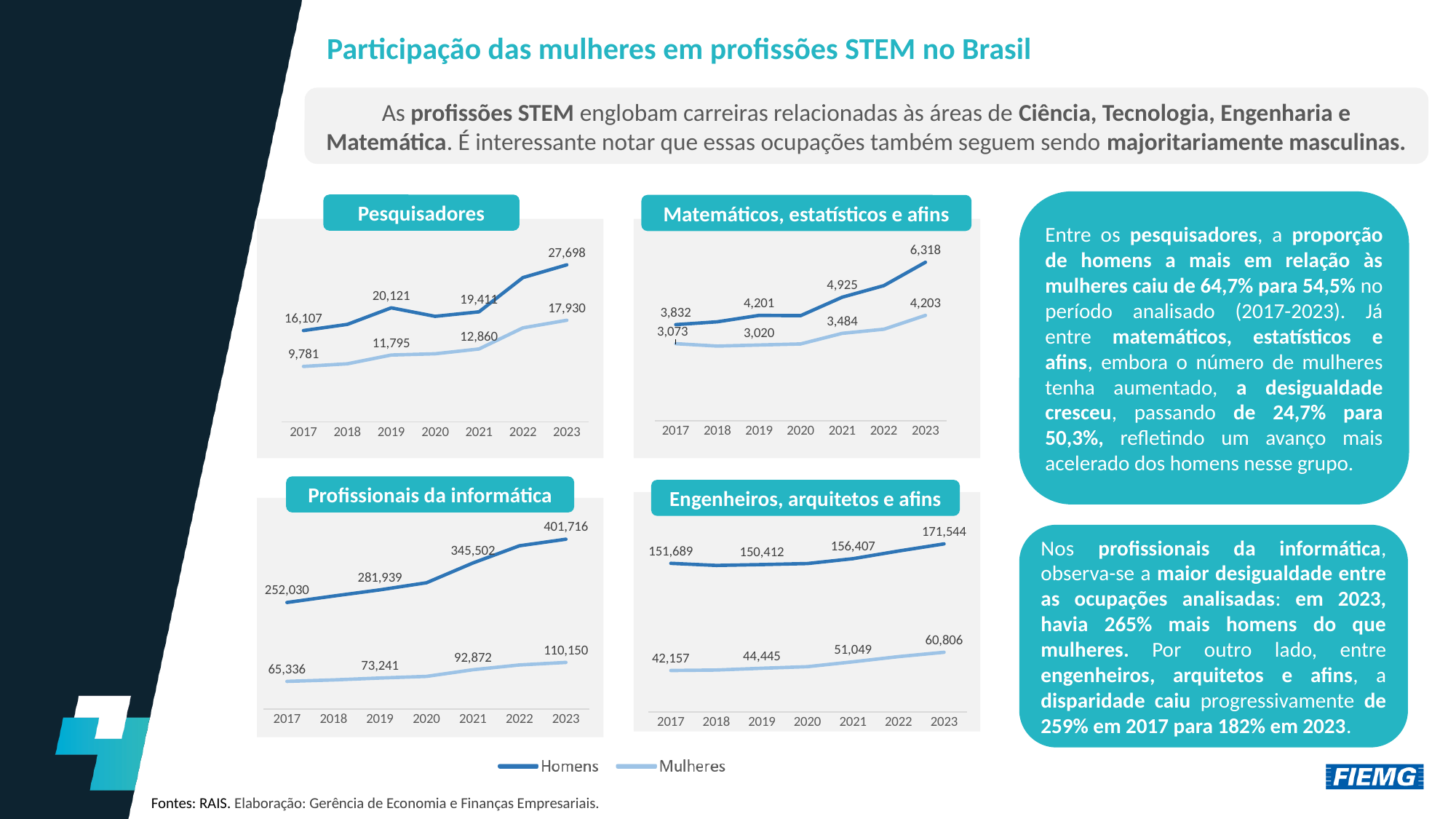
In the 'Pesquisadores' chart, what is the value for Mulheres in 2017? 9,781 In the 'Engenheiros, arquitetos e afins' chart, what is the value for Mulheres in 2019? 44,445 What kind of chart is the 'Engenheiros, arquitetos e afins' chart? Line chart In the 'Pesquisadores' chart, what is the value for Homens in 2023? 27,698 How many series does the legend list? 2 In the 'Profissionais da informática' chart, what is the difference between Homens and Mulheres in 2023? 291,566 In the 'Matemáticos, estatísticos e afins' chart, what is the difference between the Homens values in 2023 and 2017? 2,486 In the 'Pesquisadores' chart, in which labelled year is the Mulheres value highest? 2023 In the 'Engenheiros, arquitetos e afins' chart, which is larger: the Homens value in 2017 or the Homens value in 2019? 2017 In the 'Profissionais da informática' chart, what is the value for Homens in 2021? 345,502 In the 'Matemáticos, estatísticos e afins' chart, what is the value for Mulheres in 2023? 4,203 How many years are shown on the x axis of the 'Profissionais da informática' chart? 7